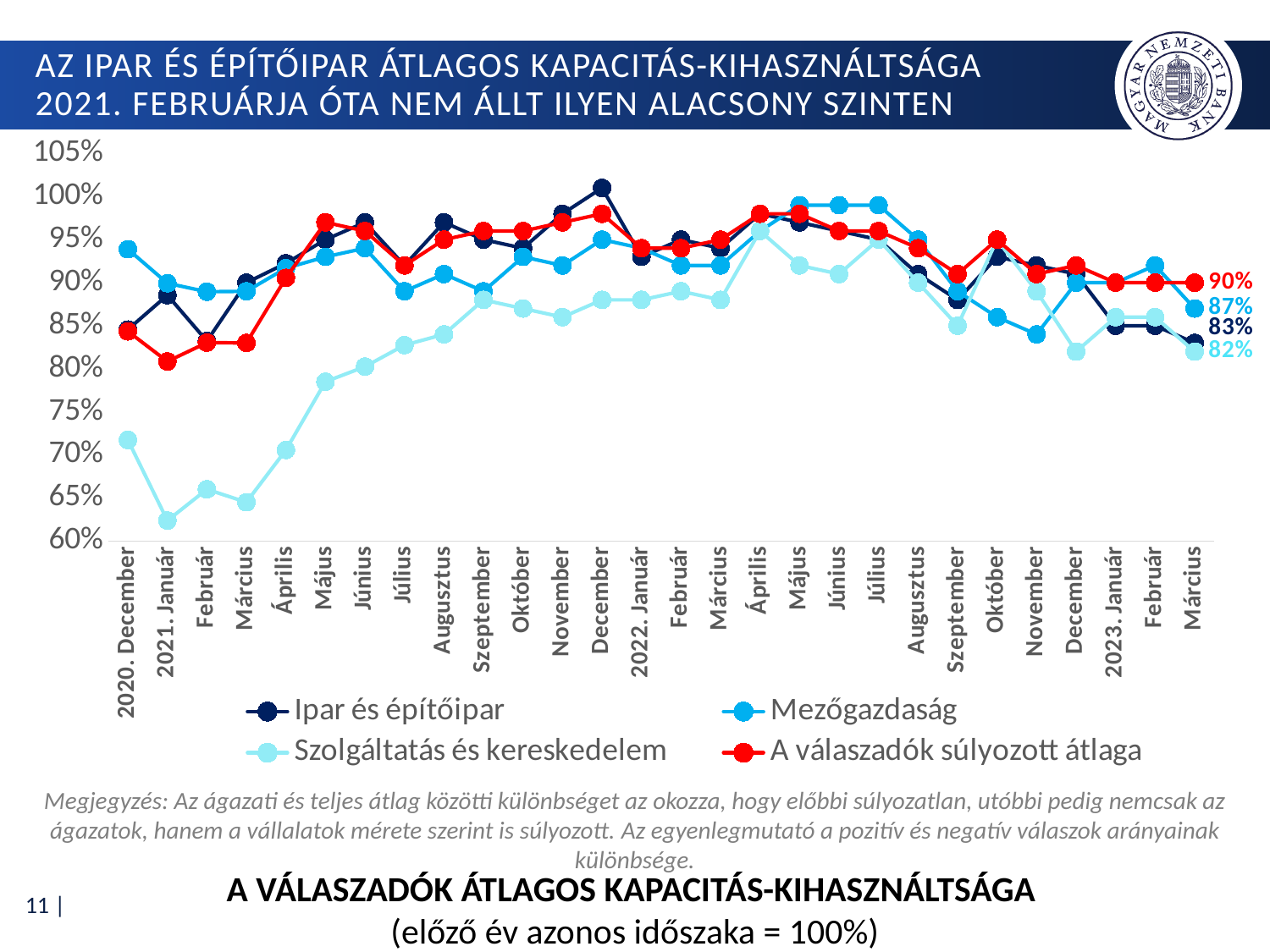
What kind of chart is shown on the slide? Line chart What is the value of 'Szolgáltatás és kereskedelem' in 2023. Március? 82% Is the value for 'Szolgáltatás és kereskedelem' in 2021. Január greater or less than 65%? less What is the difference between 'A válaszadók súlyozott átlaga' and 'Szolgáltatás és kereskedelem' in 2023. Március? 8 percentage points In 2023. Március, which is larger: 'Mezőgazdaság' or 'Ipar és építőipar'? Mezőgazdaság What is the value of 'Ipar és építőipar' in 2023. Március? 83% What is the value of 'A válaszadók súlyozott átlaga' in 2023. Március? 90% How many series does the legend list? 4 In 2023. Március, which series has the lowest value? Szolgáltatás és kereskedelem In 2023. Március, which series has the highest value? A válaszadók súlyozott átlaga Is the value for 'Ipar és építőipar' in 2021. December greater or less than 100%? greater What is the value of 'Mezőgazdaság' in 2023. Március? 87%